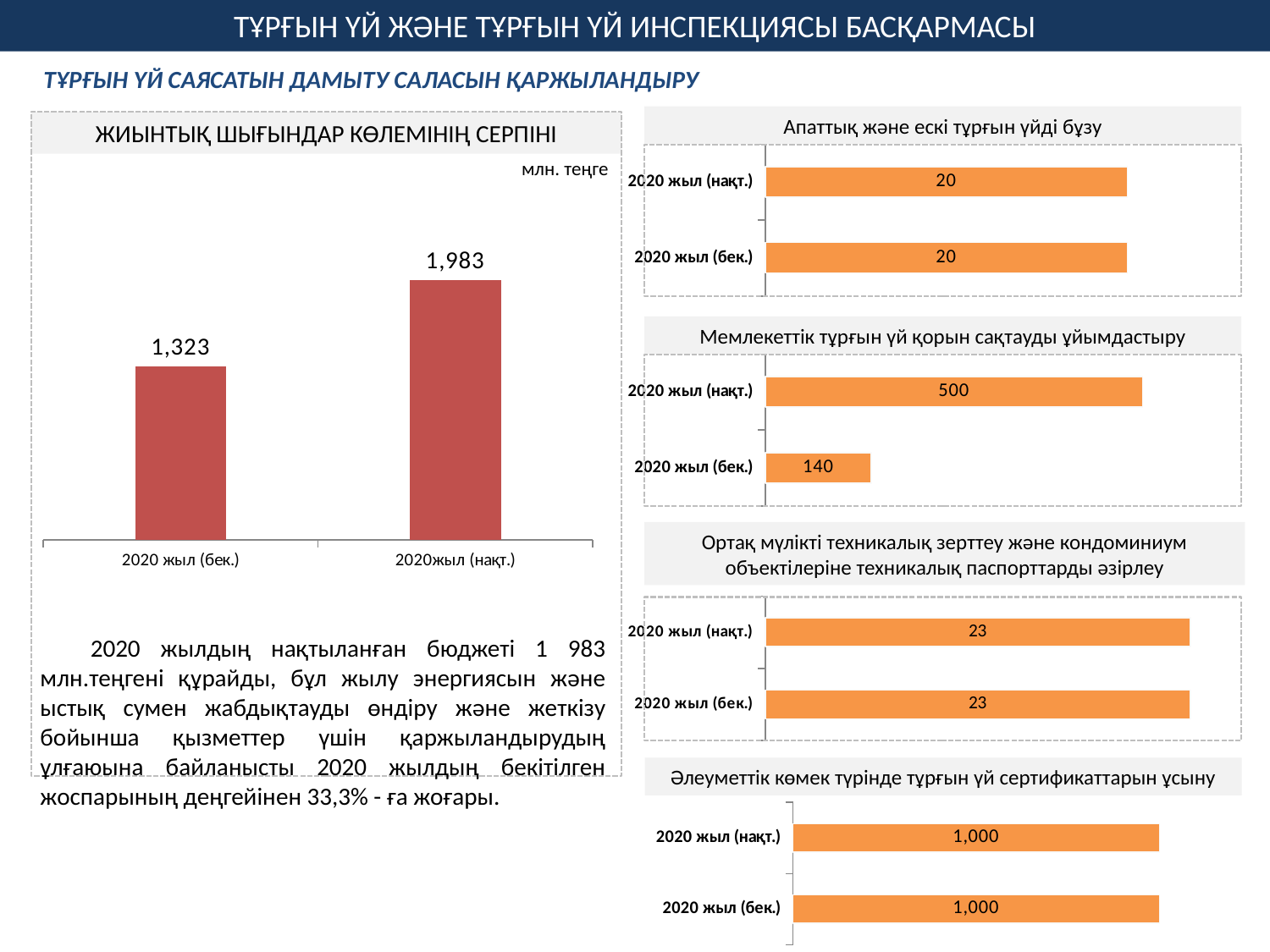
In the chart titled "Мемлекеттік тұрғын үй қорын сақтауды ұйымдастыру", what is the difference between the 2020 жыл (нақт.) and 2020 жыл (бек.) values? 360 In the chart titled "Ортақ мүлікті техникалық зерттеу және кондоминиум объектілеріне техникалық паспорттарды әзірлеу", what is the value for 2020 жыл (нақт.)? 23 In the chart titled "ЖИЫНТЫҚ ШЫҒЫНДАР КӨЛЕМІНІҢ СЕРПІНІ", what is the value for 2020 жыл (бек.)? 1,323 What kind of chart is the chart titled "ЖИЫНТЫҚ ШЫҒЫНДАР КӨЛЕМІНІҢ СЕРПІНІ"? Bar chart In the chart titled "ЖИЫНТЫҚ ШЫҒЫНДАР КӨЛЕМІНІҢ СЕРПІНІ", which category has the higher value? 2020жыл (нақт.) In the chart titled "Мемлекеттік тұрғын үй қорын сақтауды ұйымдастыру", what is the value for 2020 жыл (нақт.)? 500 In the chart titled "Әлеуметтік көмек түрінде тұрғын үй сертификаттарын ұсыну", what is the value for 2020 жыл (нақт.)? 1,000 In the chart titled "Мемлекеттік тұрғын үй қорын сақтауды ұйымдастыру", what is the value for 2020 жыл (бек.)? 140 In the chart titled "Апаттық және ескі тұрғын үйді бұзу", what is the value for 2020 жыл (бек.)? 20 In the chart titled "ЖИЫНТЫҚ ШЫҒЫНДАР КӨЛЕМІНІҢ СЕРПІНІ", what is the difference between the 2020жыл (нақт.) value and the 2020 жыл (бек.) value? 660 In the chart titled "ЖИЫНТЫҚ ШЫҒЫНДАР КӨЛЕМІНІҢ СЕРПІНІ", what is the value for 2020жыл (нақт.)? 1,983 What unit is shown in the chart titled "ЖИЫНТЫҚ ШЫҒЫНДАР КӨЛЕМІНІҢ СЕРПІНІ"? млн. теңге